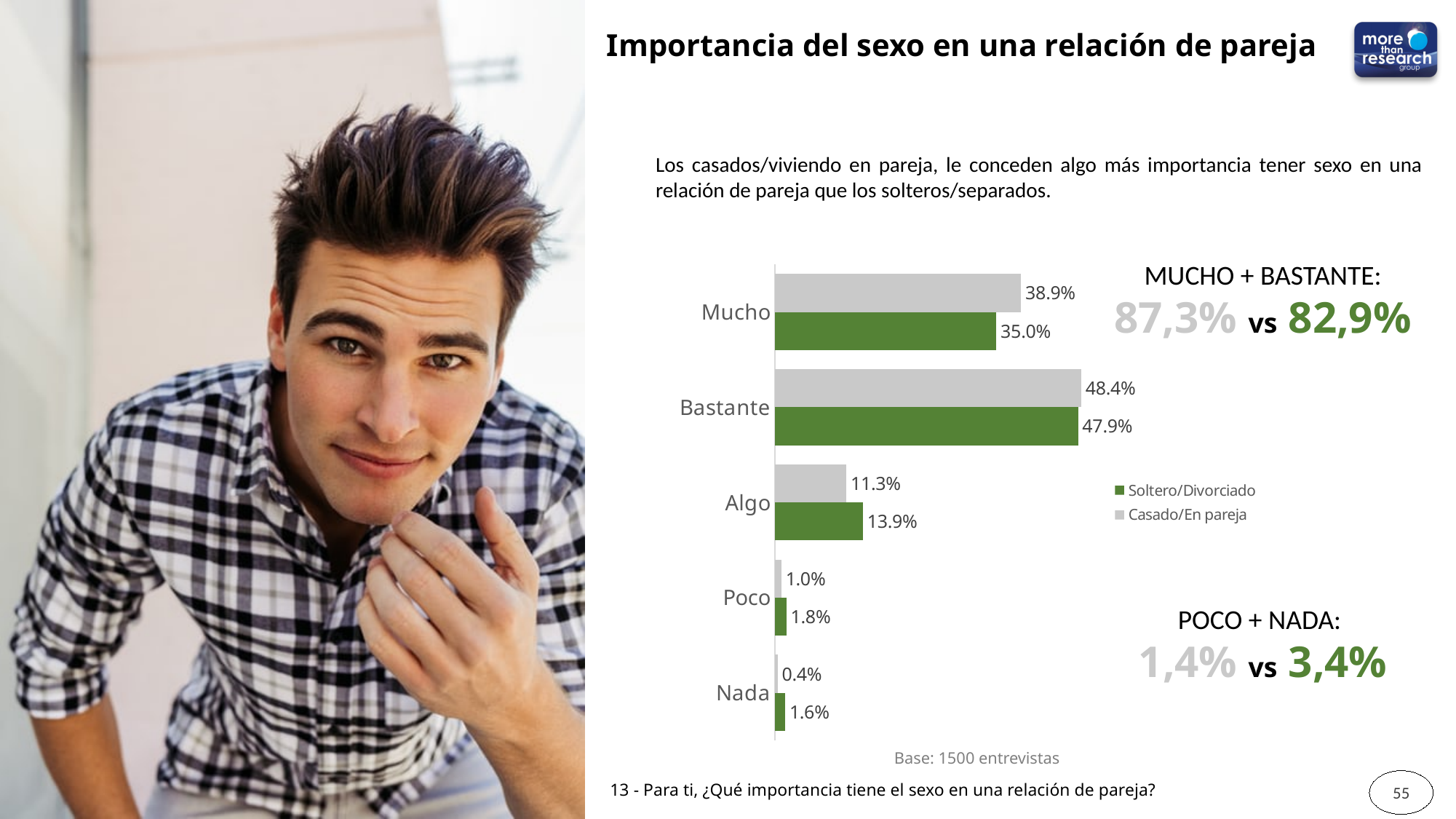
In the Algo category, which series has the larger value, Soltero/Divorciado or Casado/En pareja? Soltero/Divorciado What kind of chart is shown on the slide? Bar chart What is the value for Soltero/Divorciado in the Bastante category? 47.9% How many categories are shown on the chart? 5 What is the value for Casado/En pareja in the Mucho category? 38.9% What is the value for Casado/En pareja in the Nada category? 0.4% Which category has the highest value for Casado/En pareja? Bastante What is the value for Soltero/Divorciado in the Algo category? 13.9% Which colour represents the Soltero/Divorciado series in the chart? Green How many series does the legend list? 2 Which category has the lowest value for Soltero/Divorciado? Nada What is the difference between the Casado/En pareja and Soltero/Divorciado values in the Mucho category? 3.9%